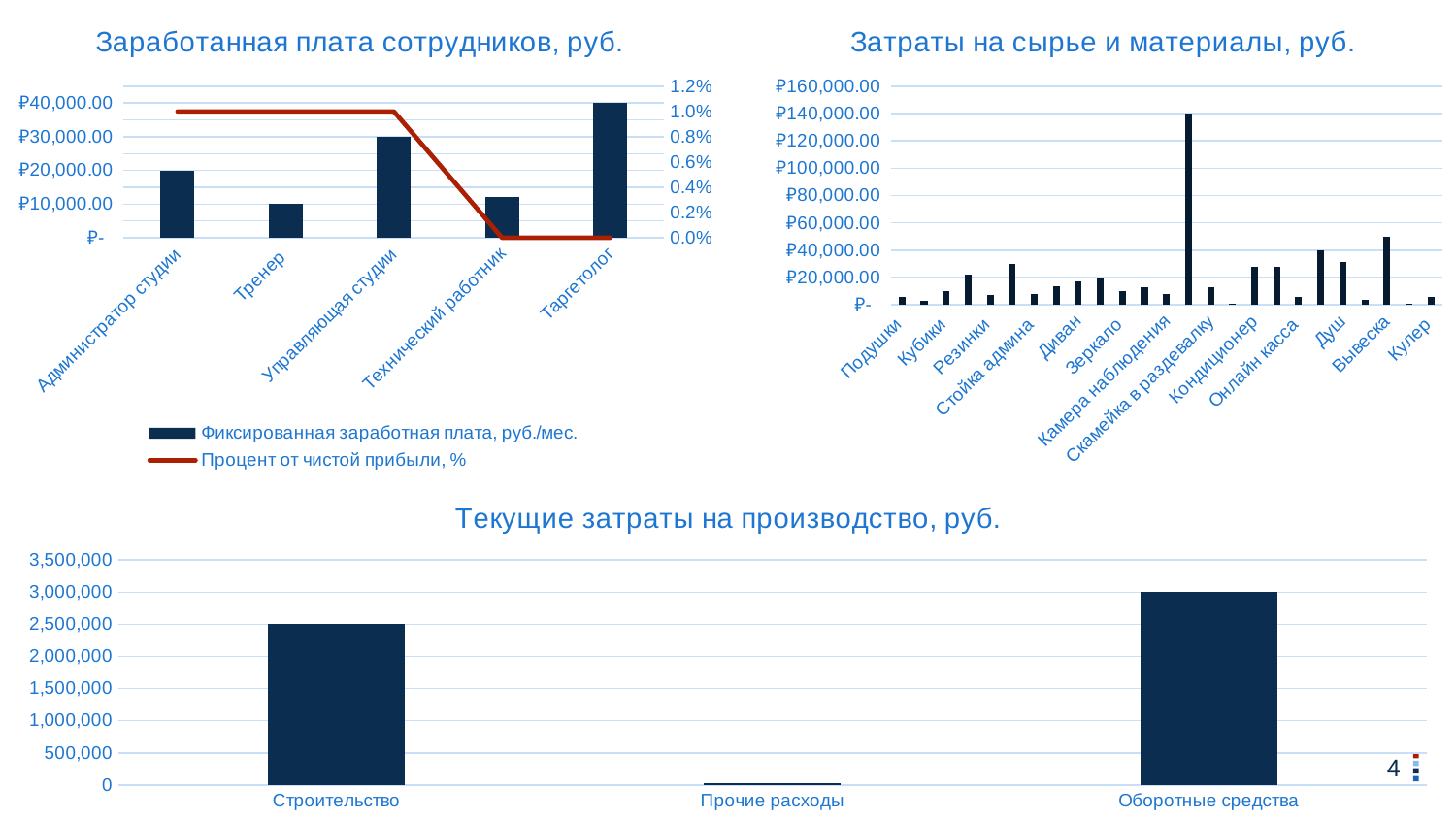
In the chart 'Заработанная плата сотрудников, руб.', which category has the highest fixed salary bar? Таргетолог How many categories are shown in the chart 'Текущие затраты на производство, руб.'? 3 In the chart 'Текущие затраты на производство, руб.', what is the value for Оборотные средства? 3,000,000 How many series does the legend list in the chart 'Заработанная плата сотрудников, руб.'? 2 In the chart 'Затраты на сырье и материалы, руб.', is the tallest bar greater or less than ₽120,000.00? greater What type of chart is 'Текущие затраты на производство, руб.'? bar chart In the chart 'Текущие затраты на производство, руб.', what is the difference between Оборотные средства and Строительство? 500,000 In the chart 'Заработанная плата сотрудников, руб.', what is the 'Процент от чистой прибыли, %' value for Таргетолог? 0.0% In the chart 'Текущие затраты на производство, руб.', what is the value for Строительство? 2,500,000 In the chart 'Текущие затраты на производство, руб.', which category has the lowest value? Прочие расходы In the chart 'Заработанная плата сотрудников, руб.', is the fixed salary bar for Технический работник greater or less than ₽20,000.00? less In the chart 'Текущие затраты на производство, руб.', which category has the highest value? Оборотные средства